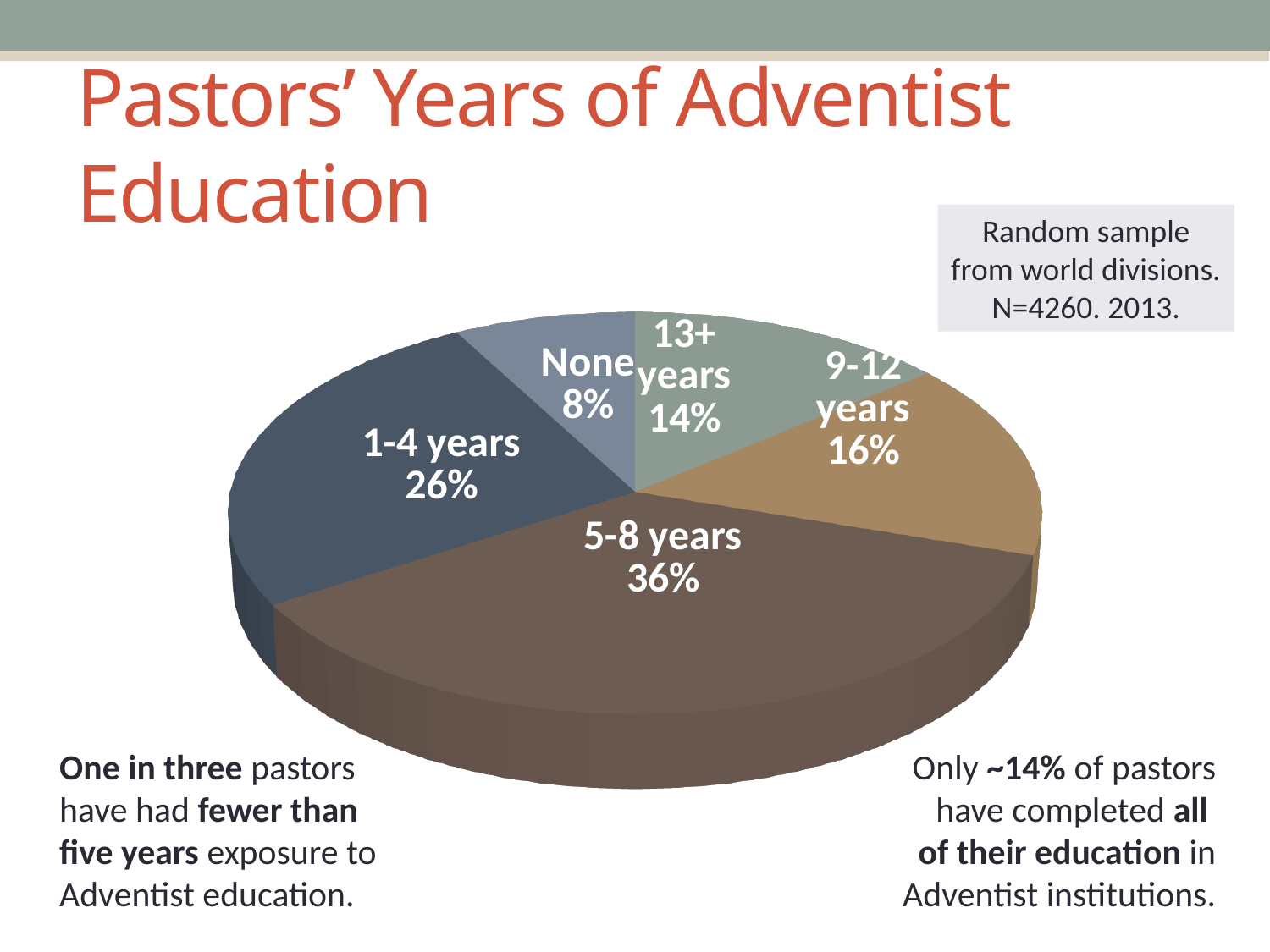
What share of pastors have 9-12 years of Adventist education? 16% What kind of chart is shown on the slide? Pie chart How many categories (slices) does the pie chart have? 5 Which is larger, the share for 9-12 years or the share for 13+ years? 9-12 years Which category has the smallest share of the pie? None What is the title of the slide containing the chart? Pastors' Years of Adventist Education What share of pastors have no Adventist education (None)? 8% What is the difference in percentage points between the 5-8 years slice and the 1-4 years slice? 10 What share of pastors have 5-8 years of Adventist education? 36% What share of pastors have 13+ years of Adventist education? 14% What is the combined share of the None and 1-4 years slices? 34% Which category has the largest share of the pie? 5-8 years